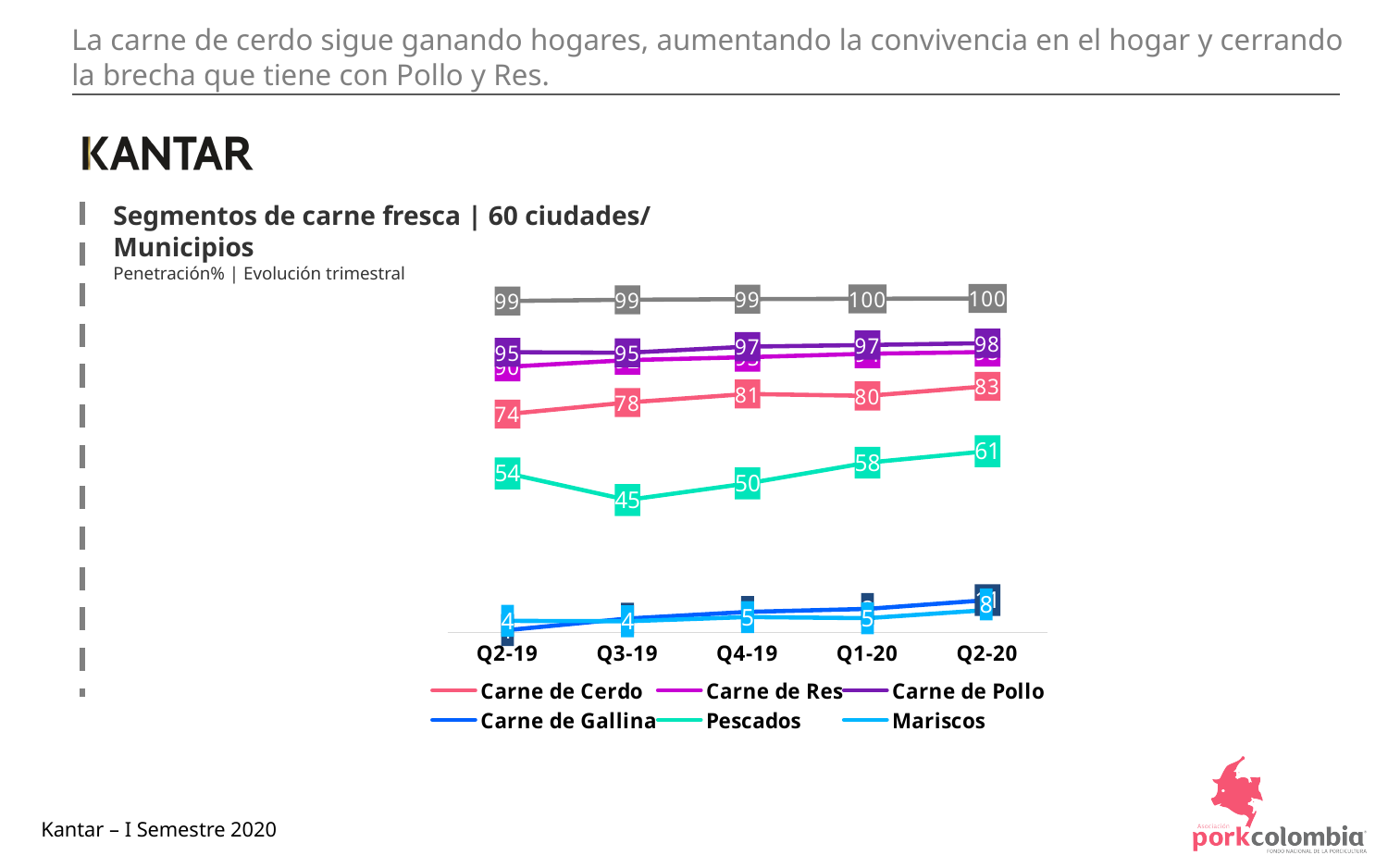
Does the value for Carne de Cerdo generally rise or fall from Q2-19 to Q2-20? Rise What is the value for Carne de Cerdo in Q2-20? 83 What is the value for Carne de Pollo in Q2-20? 98 How many quarters are shown on the x axis? 5 By how much did the value for Carne de Cerdo increase from Q2-19 to Q2-20? 9 What kind of chart is shown on the slide? Line chart What is the value for Pescados in Q3-19? 45 What is the value for Pescados in Q2-20? 61 In which quarter is the value for Carne de Cerdo highest? Q2-20 In which quarter is the value for Pescados lowest? Q3-19 Which is larger in Q1-20, the value for Carne de Cerdo or the value for Pescados? Carne de Cerdo How many series does the legend list? 6